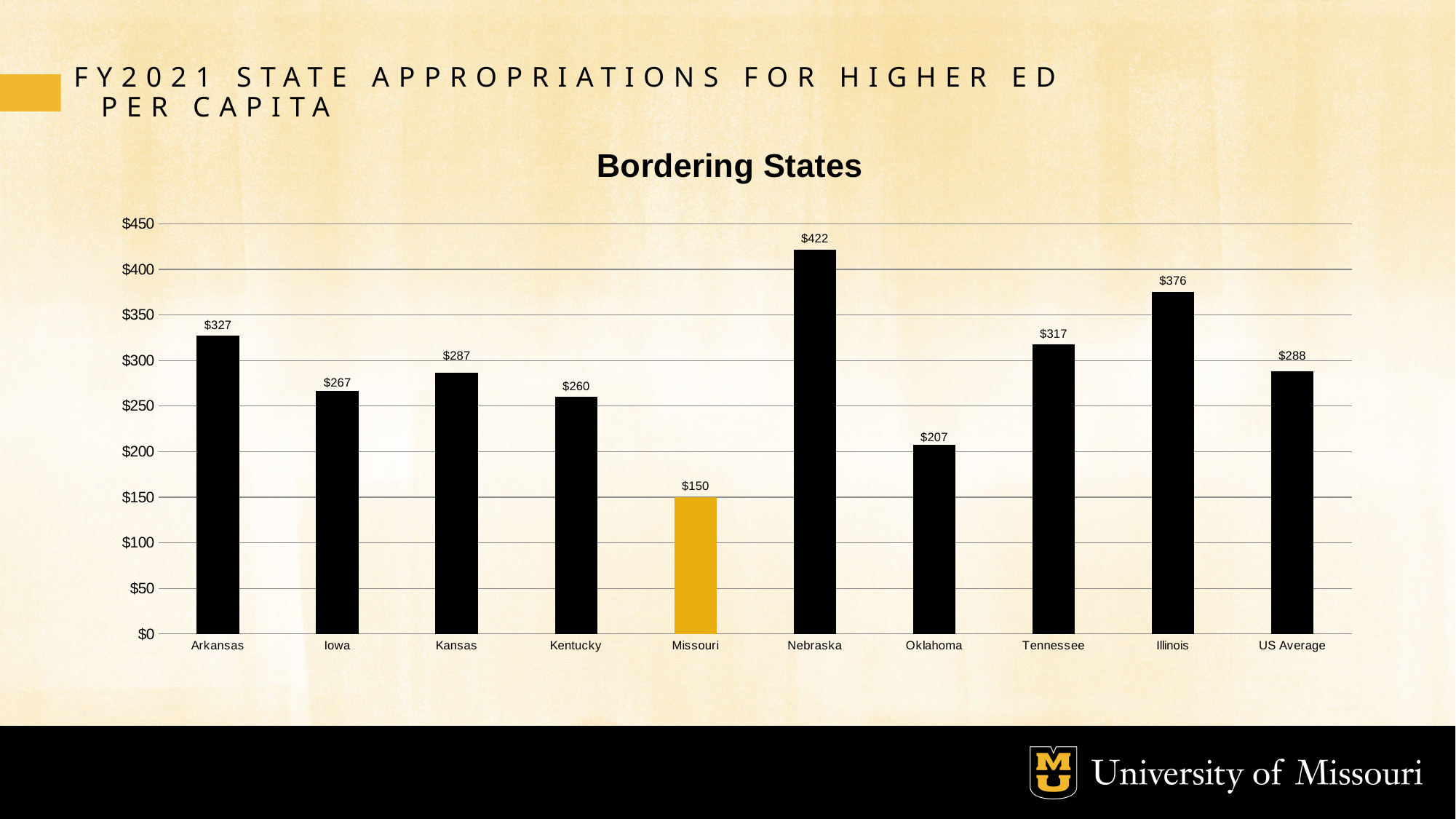
What is the title of the chart? Bordering States What is the difference between the values for Illinois and Tennessee? $59 What is the difference between the values for Nebraska and Missouri? $272 Which category has the lowest value? Missouri What is the value for US Average? $288 What kind of chart is shown on the slide? bar chart What is the value for Nebraska? $422 Which category has the highest value? Nebraska What is the value for Missouri? $150 Which is larger, the value for Arkansas or the value for Kansas? Arkansas How many categories are shown on the x axis? 10 Is the value for Oklahoma greater or less than $250? less